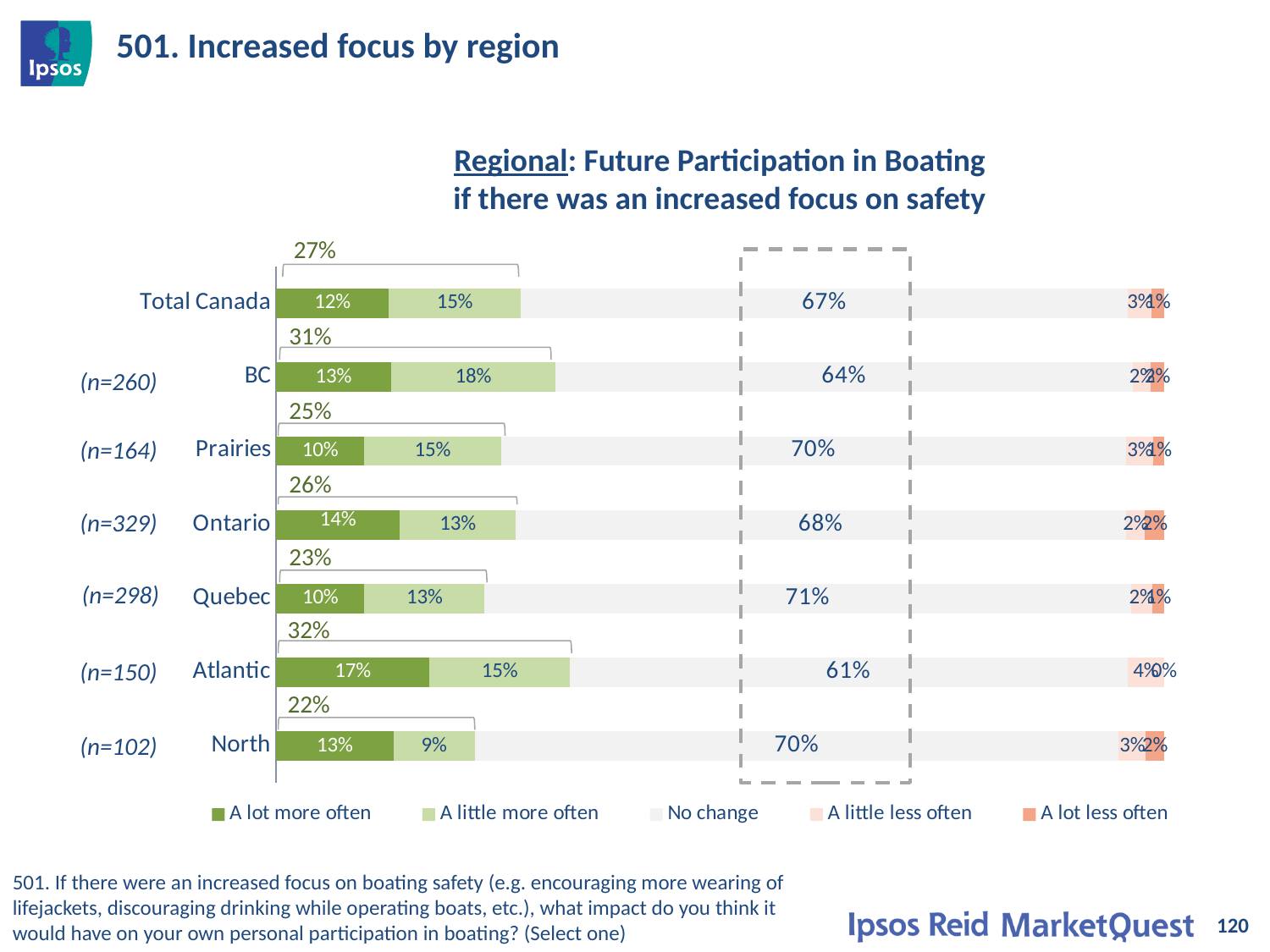
Which region has the lowest 'No change' value? Atlantic What is the difference between the 'No change' values for Quebec and Atlantic? 10% What kind of chart is shown on the slide? Stacked bar chart Which region has the highest 'No change' value? Quebec Which is larger, the 'A lot more often' value for Ontario or for Prairies? Ontario What is the 'No change' value for Total Canada? 67% How many regions (categories) are plotted on the chart, including Total Canada? 7 What is the combined 'more often' total shown above the bar for North? 22% What is the title of the chart? Regional: Future Participation in Boating if there was an increased focus on safety How many series does the legend list? 5 What is the 'A little more often' value for BC? 18% What is the 'A lot more often' value for Atlantic? 17%